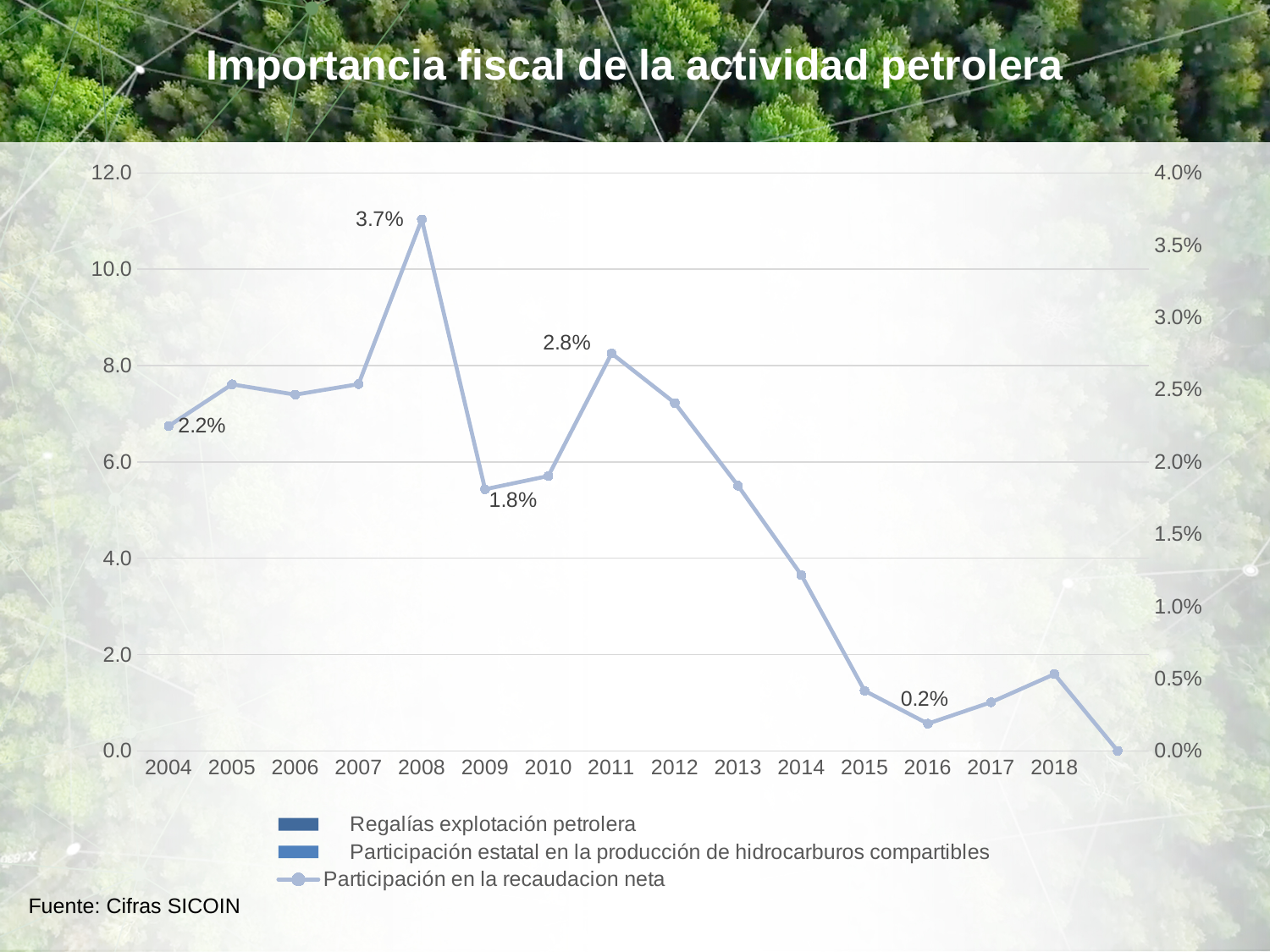
Is the Participación en la recaudacion neta value for 2012 greater or less than 2.0%? greater What is the difference between the Participación en la recaudacion neta values for 2008 and 2009? 1.9 percentage points What is the value of Participación en la recaudacion neta for 2008? 3.7% What is the value of Participación en la recaudacion neta for 2009? 1.8% How many series does the legend list? 3 What is the value of Participación en la recaudacion neta for 2016? 0.2% Does Participación en la recaudacion neta rise or fall from 2011 to 2016? fall What is the value of Participación en la recaudacion neta for 2004? 2.2% In which year does Participación en la recaudacion neta reach its highest value? 2008 Which year has the larger Participación en la recaudacion neta value, 2004 or 2011? 2011 Is the Participación en la recaudacion neta value for 2014 greater or less than 1.5%? less What is the title of the slide containing the chart? Importancia fiscal de la actividad petrolera